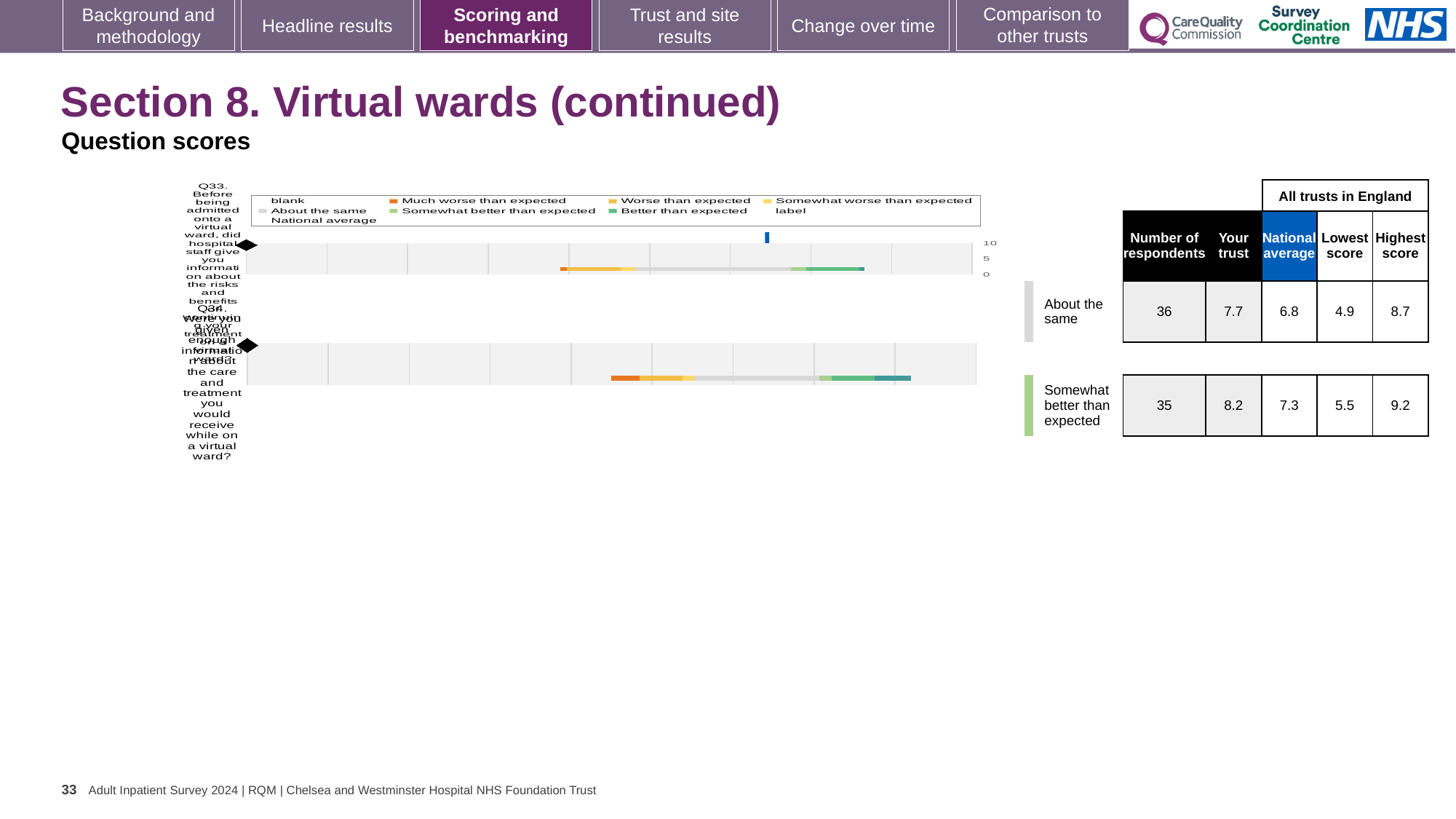
Which benchmark category is Q33 placed in? About the same How many respondents answered Q33? 36 How many questions (bars) are plotted in the chart? 2 What is the 'Your trust' score for Q33 in the table beside the chart? 7.7 What kind of chart is shown on the slide? bar chart Which question has the higher 'Your trust' score, Q33 or Q34? Q34 What is the highest score across all trusts in England for Q34? 9.2 What is the national average score for Q34 in the table beside the chart? 7.3 What is the difference between the highest and lowest scores for Q33? 3.8 By how much does the 'Your trust' score for Q34 exceed the national average for Q34? 0.9 What colour does the legend use for 'Better than expected'? green What colour does the legend use for 'Much worse than expected'? orange